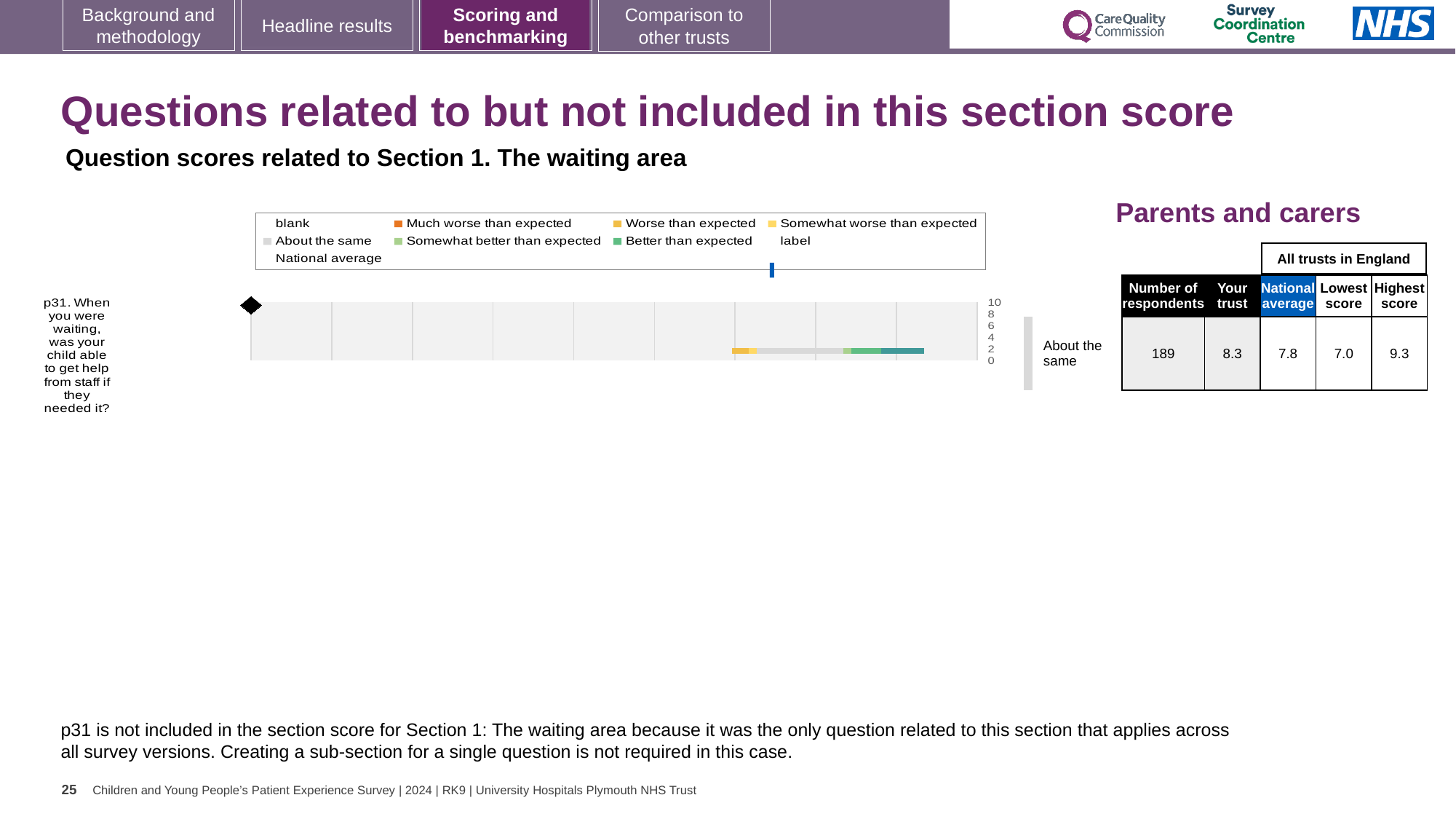
In the table next to the chart, how many respondents answered p31? 189 In the table next to the chart, what is the national average score for p31? 7.8 What kind of chart is shown for question p31? bar chart For p31, which is larger: the 'Your trust' score or the national average? Your trust How many questions are plotted in the chart? 1 How many entries does the chart legend list? 9 In the table next to the chart, what is the 'Your trust' score for p31? 8.3 What benchmark category label is shown to the right of the p31 bar? About the same In the table next to the chart, what is the highest score across all trusts in England for p31? 9.3 Which question number is plotted in the chart? p31 What is the difference between the highest score and the lowest score for p31 in the table? 2.3 In the table next to the chart, what is the lowest score across all trusts in England for p31? 7.0